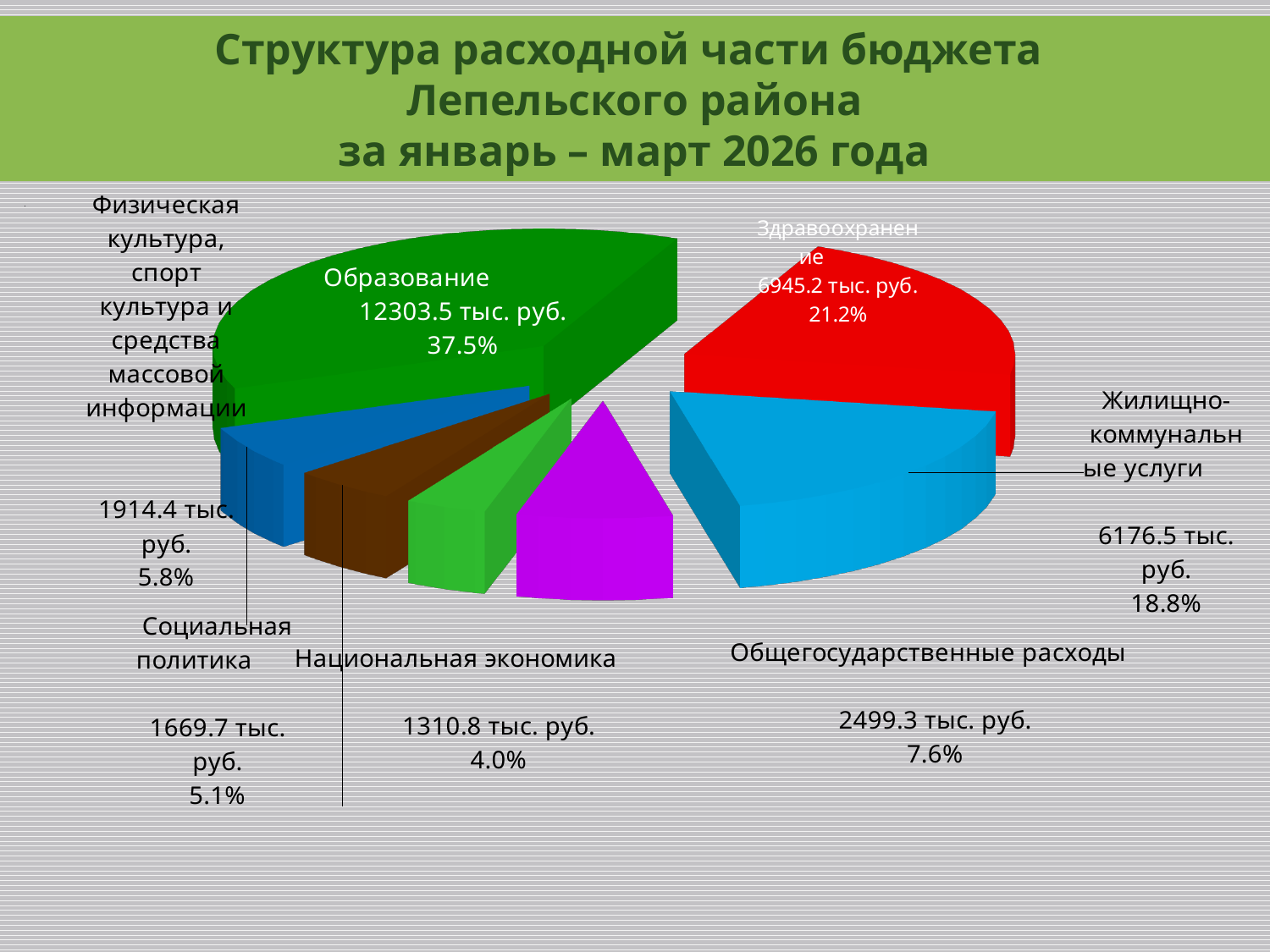
What share of the pie does Общегосударственные расходы take? 7.6% What is the value for Образование? 12303.5 тыс. руб. What is the difference in percentage share between Здравоохранение and Жилищно-коммунальные услуги? 2.4% Which category has the largest share of the budget expenditure? Образование How many categories (slices) does the pie chart show? 7 What is the value for Жилищно-коммунальные услуги? 6176.5 тыс. руб. What share of the pie does Здравоохранение take? 21.2% What period does the chart title say the budget expenditure structure covers? январь – март 2026 года What is the value for Национальная экономика? 1310.8 тыс. руб. What kind of chart is shown on the slide? pie chart Which is larger, Социальная политика or Физическая культура, спорт, культура и средства массовой информации? Физическая культура, спорт, культура и средства массовой информации Which category has the smallest share of the budget expenditure? Национальная экономика